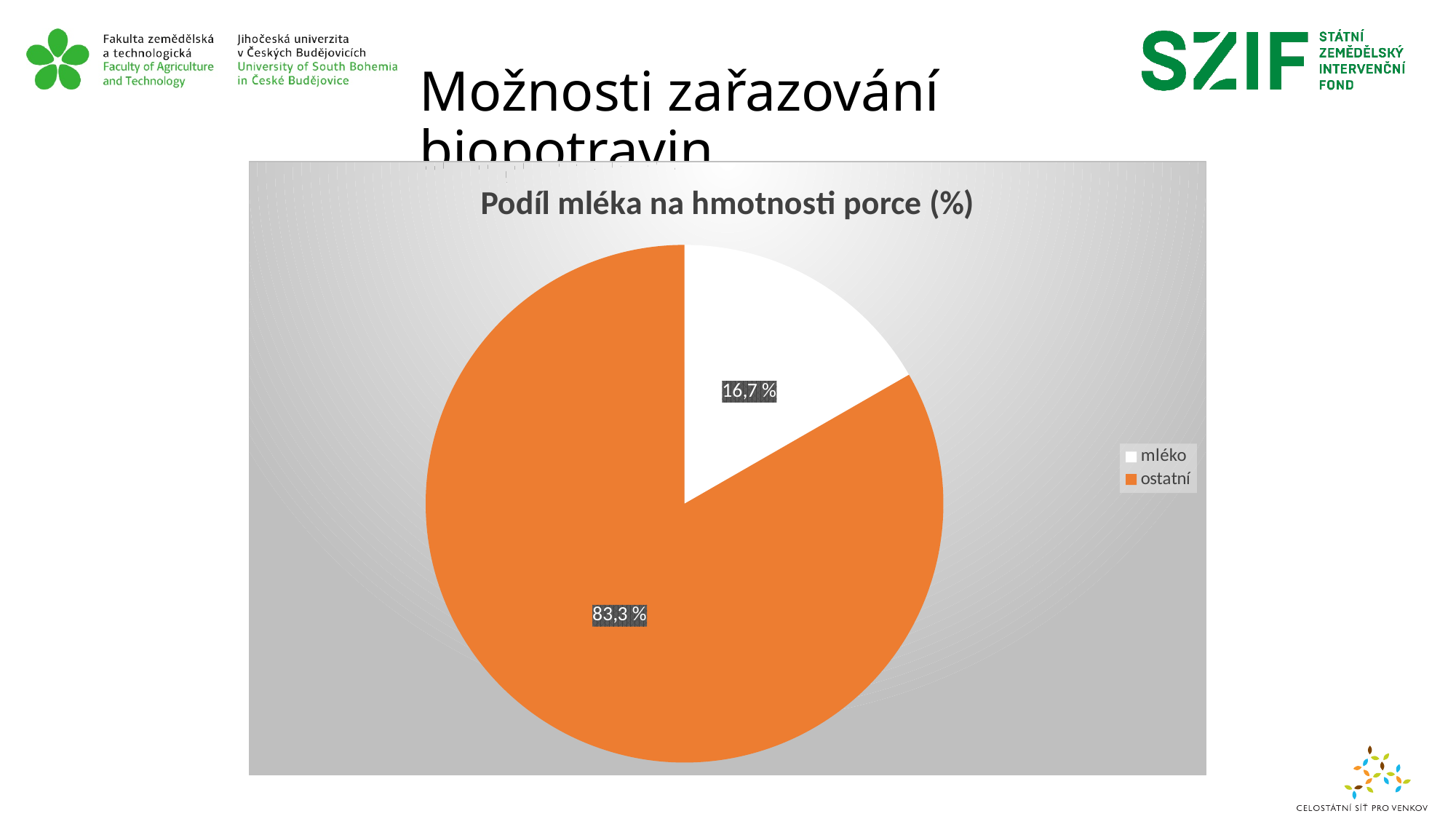
How many entries does the legend list? 2 What colour is the 'ostatní' slice? orange What kind of chart is shown on the slide? pie chart What share of the pie does the 'mléko' slice represent? 16,7 % Which category has the largest share of the pie? ostatní Which category has the smallest share of the pie? mléko Which is larger, the share for 'mléko' or for 'ostatní'? ostatní How many slices does the pie chart have? 2 What is the title of the chart? Podíl mléka na hmotnosti porce (%) What is the value shown for the 'ostatní' slice? 83,3 % What is the value shown for the 'mléko' slice? 16,7 % What is the difference between the 'ostatní' and 'mléko' shares? 66,6 %